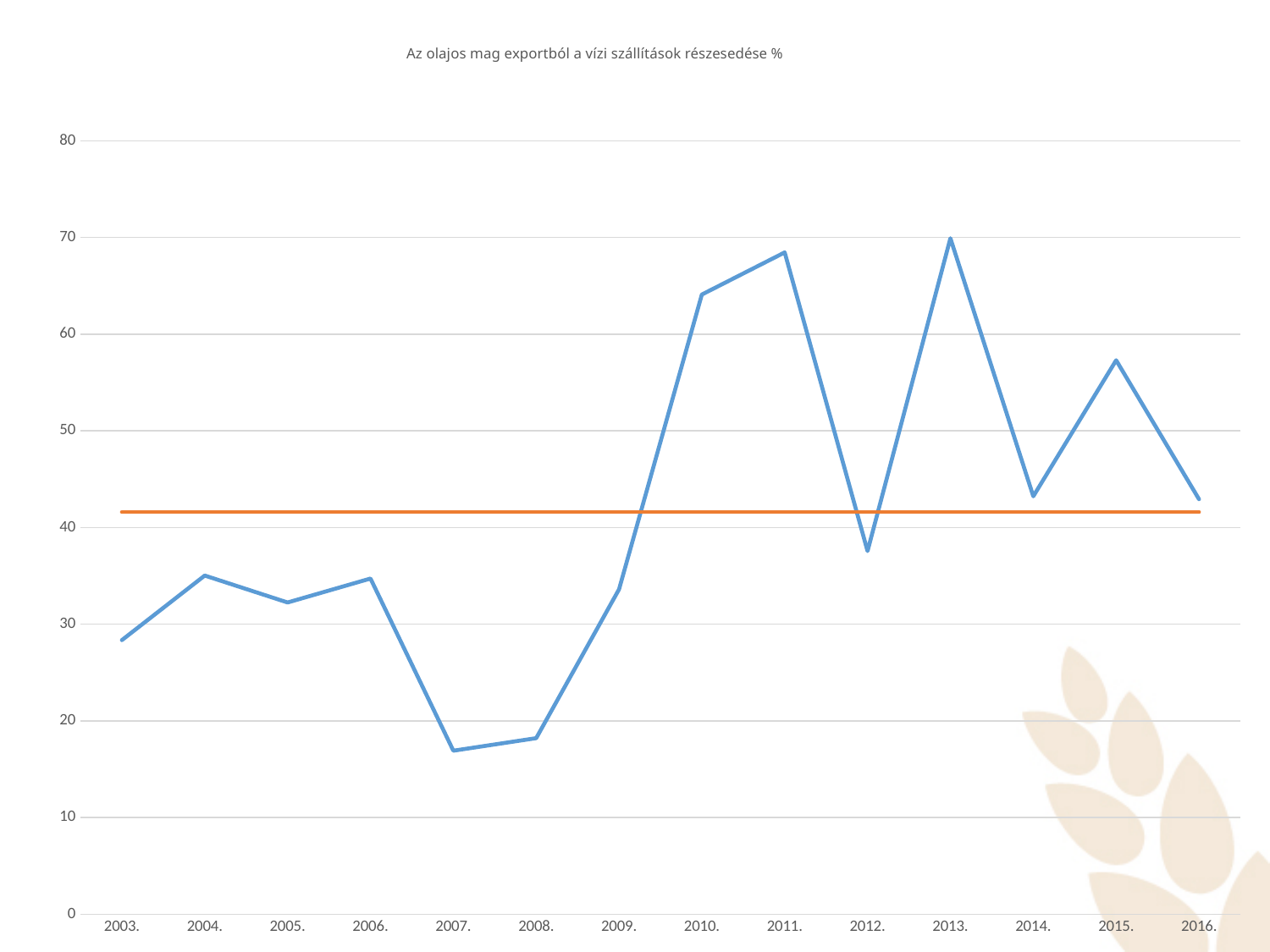
In which year does the blue line reach its highest value? 2013. What kind of chart is shown on the slide? line chart Is the value of the blue line for 2010 greater or less than 60? greater Which year has the larger value on the blue line, 2004 or 2010? 2010. How many years are plotted along the x axis? 14 What is the title of the chart? Az olajos mag exportból a vízi szállítások részesedése % Is the value of the blue line for 2015 greater or less than 50? greater Is the value of the blue line for 2007 greater or less than 20? less Does the blue line rise or fall between 2008 and 2011? rise Does the blue line rise or fall between 2006 and 2007? fall